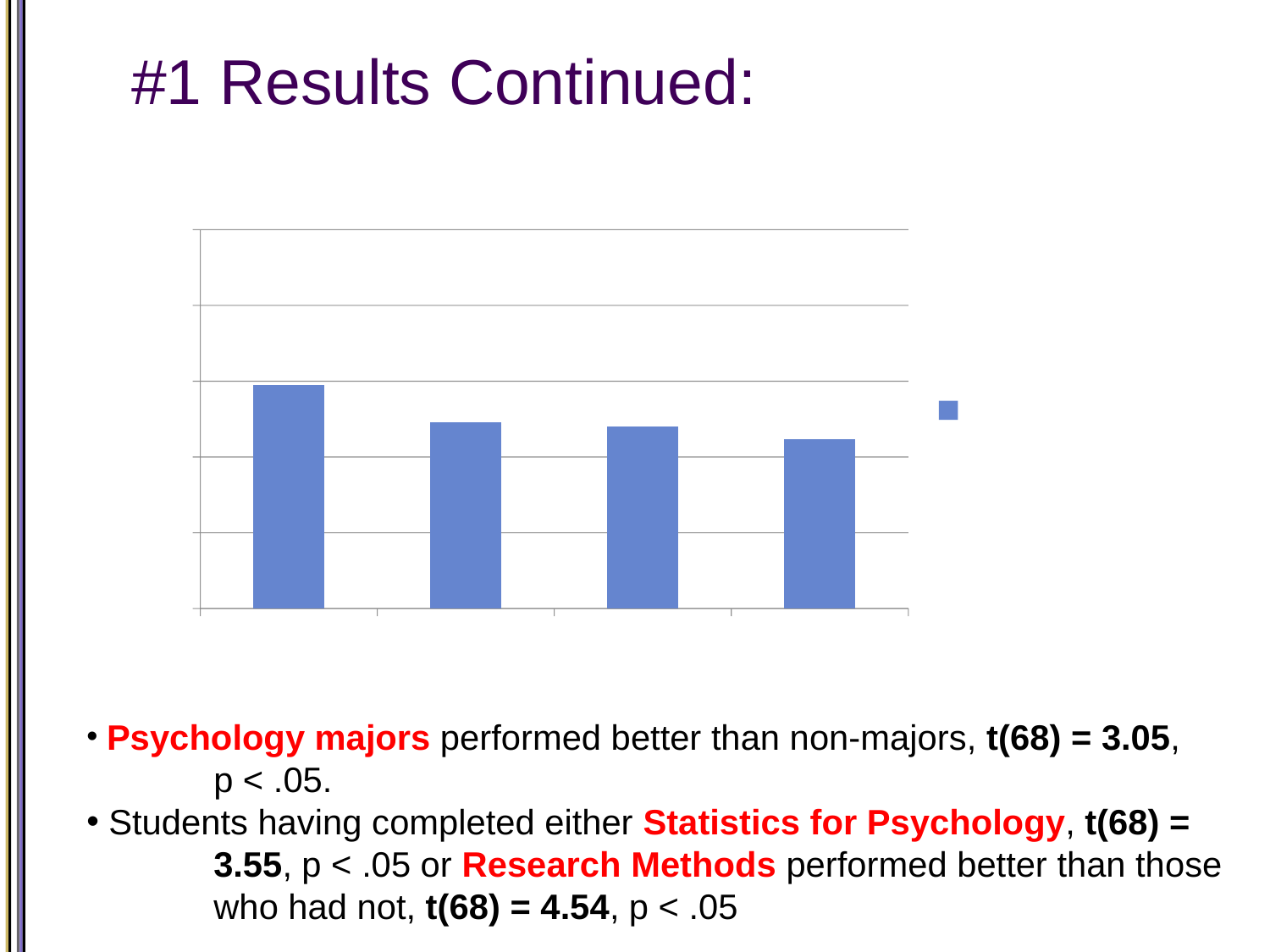
Which is taller, the second bar from the left or the rightmost bar? the second bar from the left Do the bar values rise or fall from left to right across the chart? fall Which bar in the chart is the tallest? the leftmost bar Which bar in the chart is the shortest? the rightmost bar How many bars does the chart contain? 4 Which is taller, the leftmost bar or the rightmost bar? the leftmost bar What colour are the bars in the chart? blue Does the chart display a title above the plot area? no How many series does the chart's legend list? 1 What kind of chart is shown on the slide? bar chart